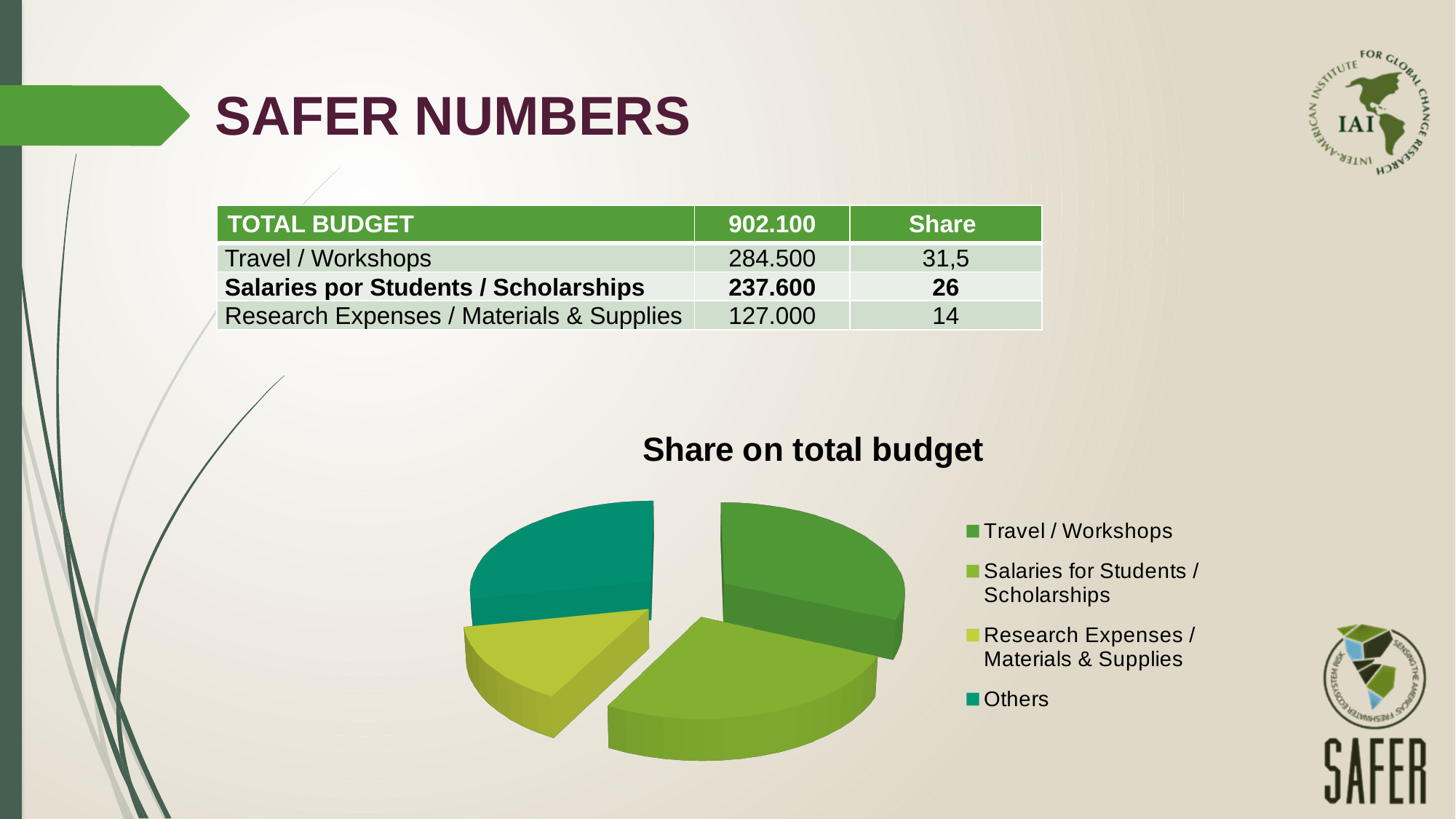
What kind of chart is shown on the slide? pie chart Which slice is larger in the pie chart, Travel / Workshops or Research Expenses / Materials & Supplies? Travel / Workshops How many slices does the pie chart have? 4 How many entries does the legend of the pie chart list? 4 Which slice is larger in the pie chart, Salaries for Students / Scholarships or Research Expenses / Materials & Supplies? Salaries for Students / Scholarships Which category has the smallest slice in the pie chart? Research Expenses / Materials & Supplies According to the slide, what share of the total budget does Research Expenses / Materials & Supplies have? 14 What is the title of the chart on the slide? Share on total budget Which legend entry of the pie chart is shown in teal? Others According to the slide, what share of the total budget does Travel / Workshops have? 31,5